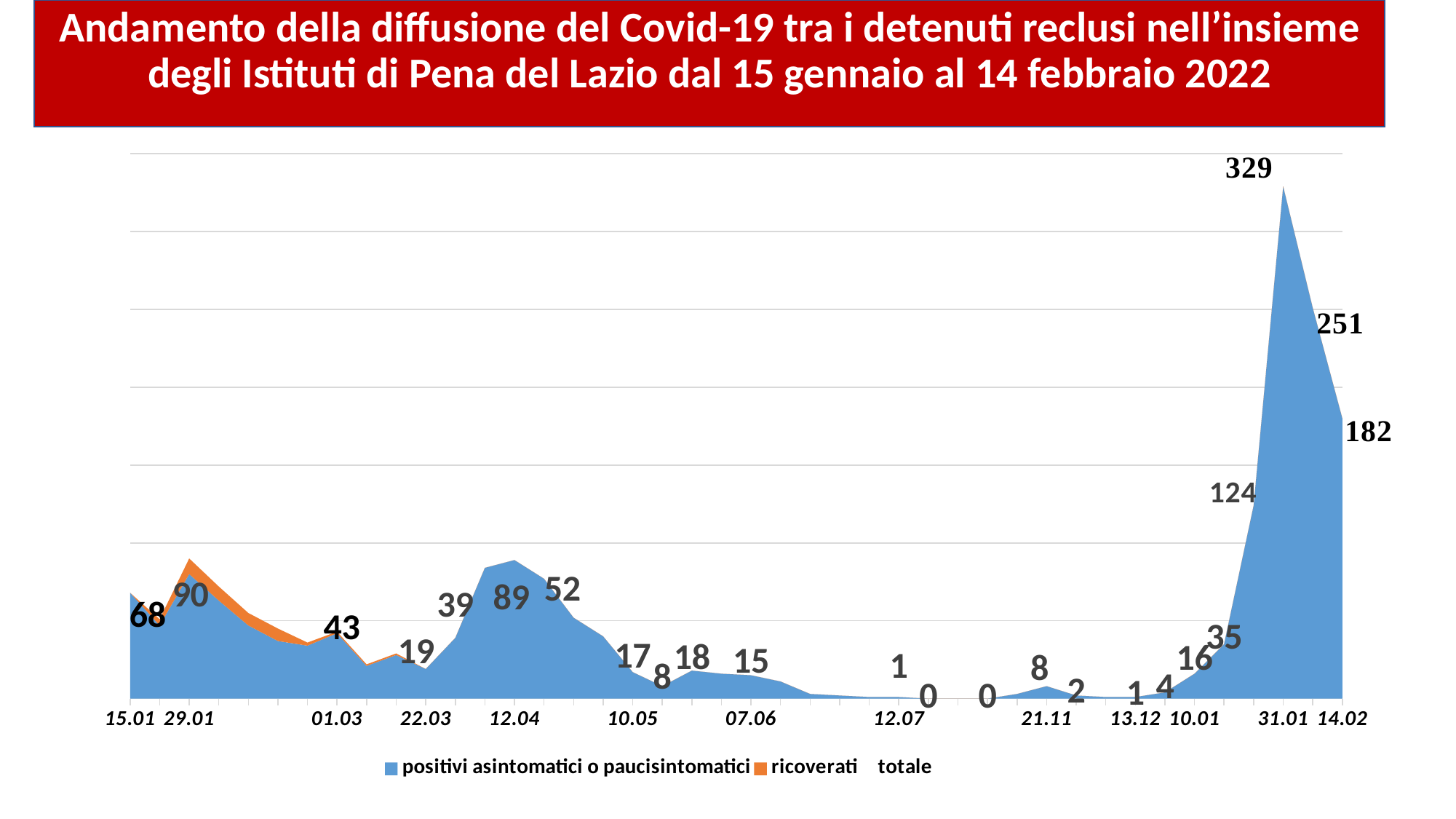
What kind of chart is shown on the slide? Area chart What value is labelled at 29.01? 90 What value is labelled at 15.01? 68 What value is labelled at 01.03? 43 What value is labelled at 14.02? 182 Do the values rise or fall from 31.01 to 14.02? Fall Which is larger, the value at 29.01 or the value at 15.01? 29.01 How many series does the legend list? 3 What value is labelled at 31.01? 329 What is the highest value labelled on the chart? 329 What is the lowest value labelled on the chart? 0 What is the difference between the value at 31.01 and the value at 14.02? 147